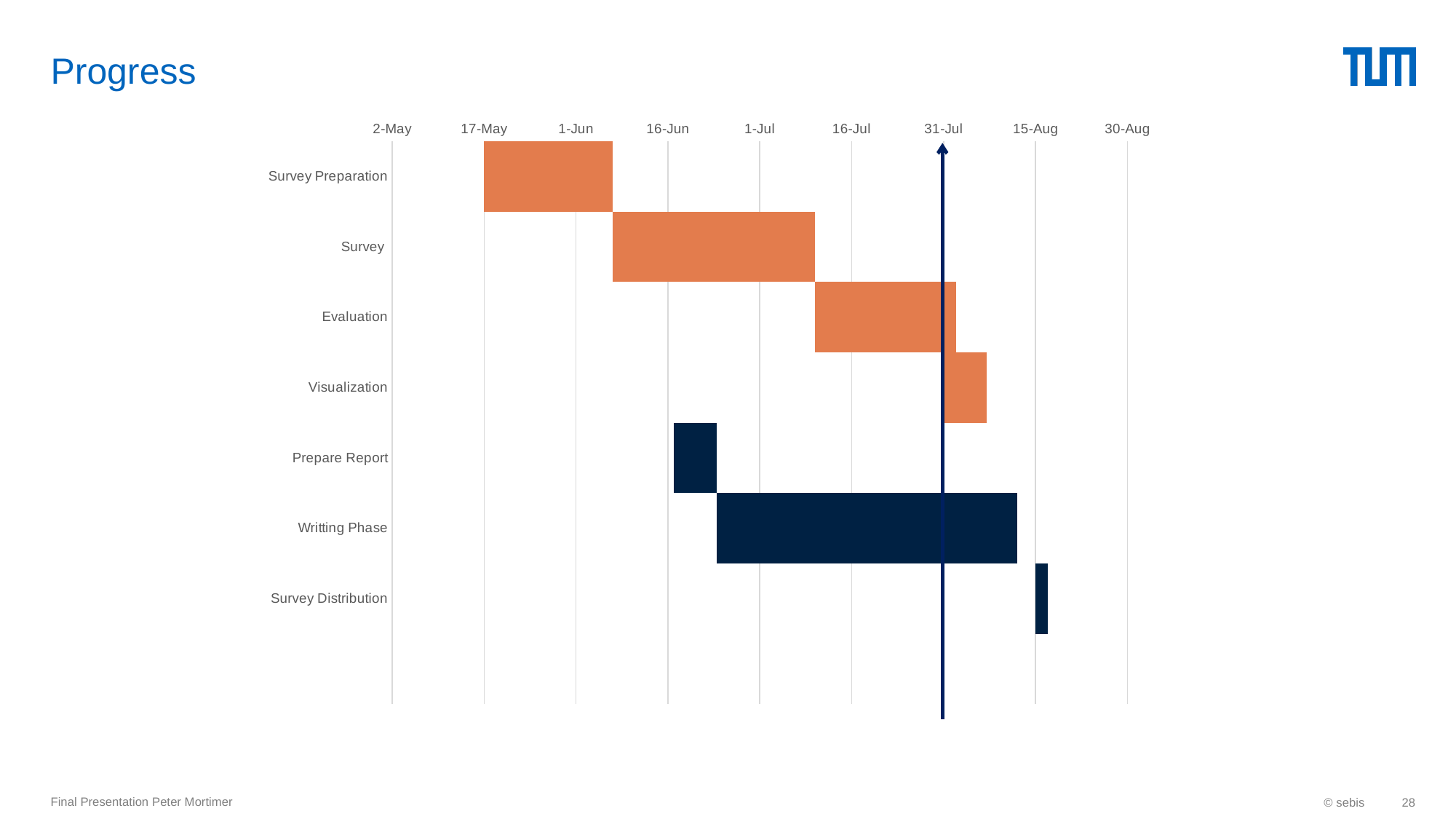
At which date tick is the vertical arrow line drawn on the chart? 31-Jul On which date does the Survey Distribution bar start? 15-Aug Is the Survey bar longer or shorter than the Evaluation bar? longer Does the Survey bar end before or after 1-Jul? after Which task has the longest bar in the chart? Writting Phase How many date ticks are shown along the horizontal axis? 9 Does the Writting Phase bar start before or after 1-Jul? before On which date does the Survey Preparation bar start? 17-May How many tasks are listed on the vertical axis of the chart? 7 Which task has the shortest bar in the chart? Survey Distribution What kind of chart is shown on the slide? bar chart (Gantt chart) Which task's bar starts first in the chart? Survey Preparation